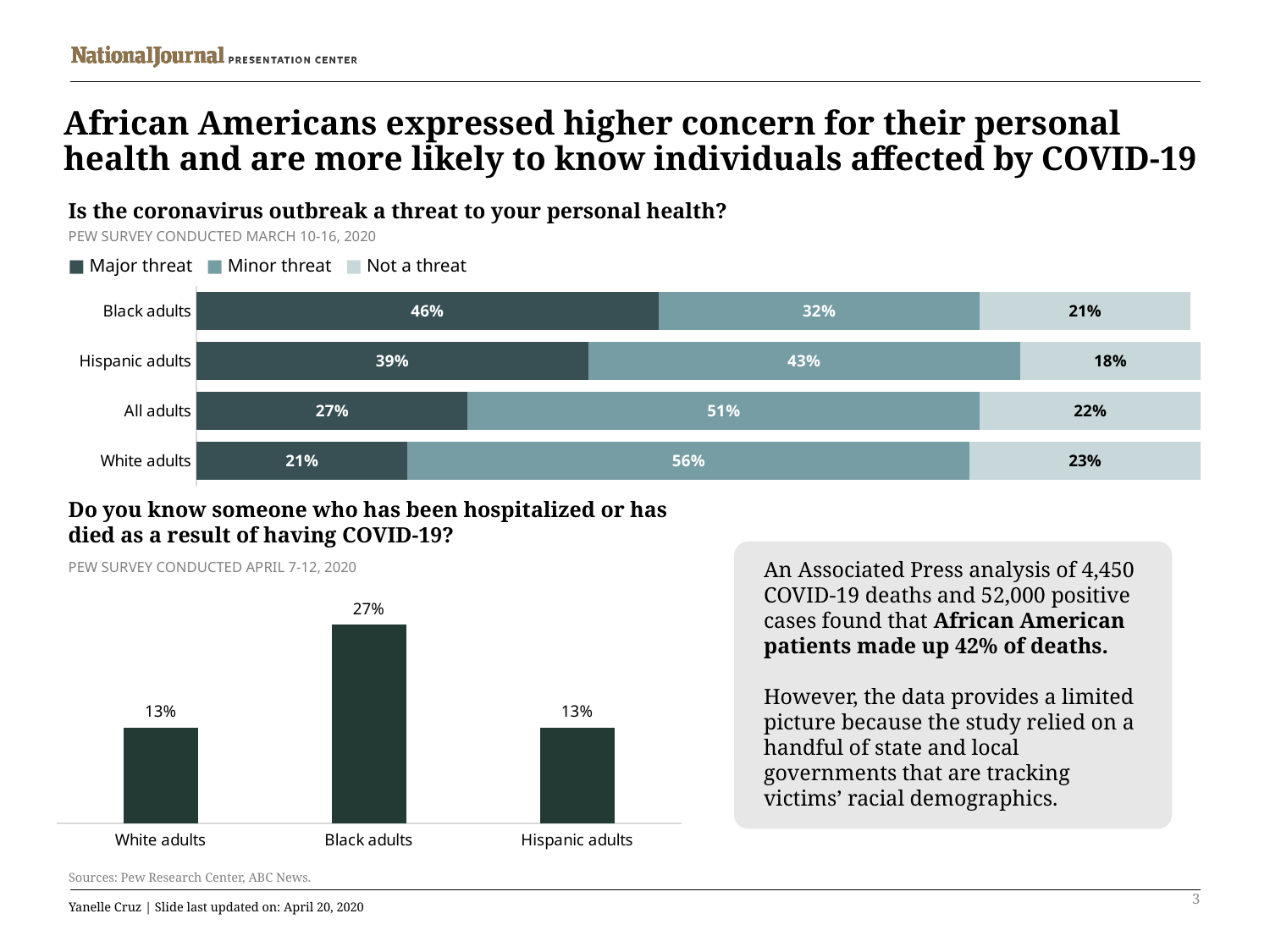
In the chart 'Is the coronavirus outbreak a threat to your personal health?', how many series does the legend list? 3 In the chart 'Do you know someone who has been hospitalized or has died as a result of having COVID-19?', what is the difference between Black adults and White adults? 14 percentage points In the chart 'Is the coronavirus outbreak a threat to your personal health?', is the 'Minor threat' share larger for All adults or for Hispanic adults? All adults In the chart 'Is the coronavirus outbreak a threat to your personal health?', which group has the highest share saying 'Major threat'? Black adults In the chart 'Do you know someone who has been hospitalized or has died as a result of having COVID-19?', what is the value for Black adults? 27% In the chart 'Is the coronavirus outbreak a threat to your personal health?', which group has the lowest share saying 'Major threat'? White adults In the chart 'Is the coronavirus outbreak a threat to your personal health?', what is the difference between the 'Major threat' shares for Black adults and White adults? 25 percentage points In the chart 'Is the coronavirus outbreak a threat to your personal health?', what percentage of White adults said it is a minor threat? 56% What kind of chart is 'Do you know someone who has been hospitalized or has died as a result of having COVID-19?'? Bar chart In the chart 'Is the coronavirus outbreak a threat to your personal health?', what percentage of Black adults said it is a major threat? 46% In the chart 'Is the coronavirus outbreak a threat to your personal health?', what is the total of the three segments for Hispanic adults? 100% In the chart 'Is the coronavirus outbreak a threat to your personal health?', how many groups are shown? 4